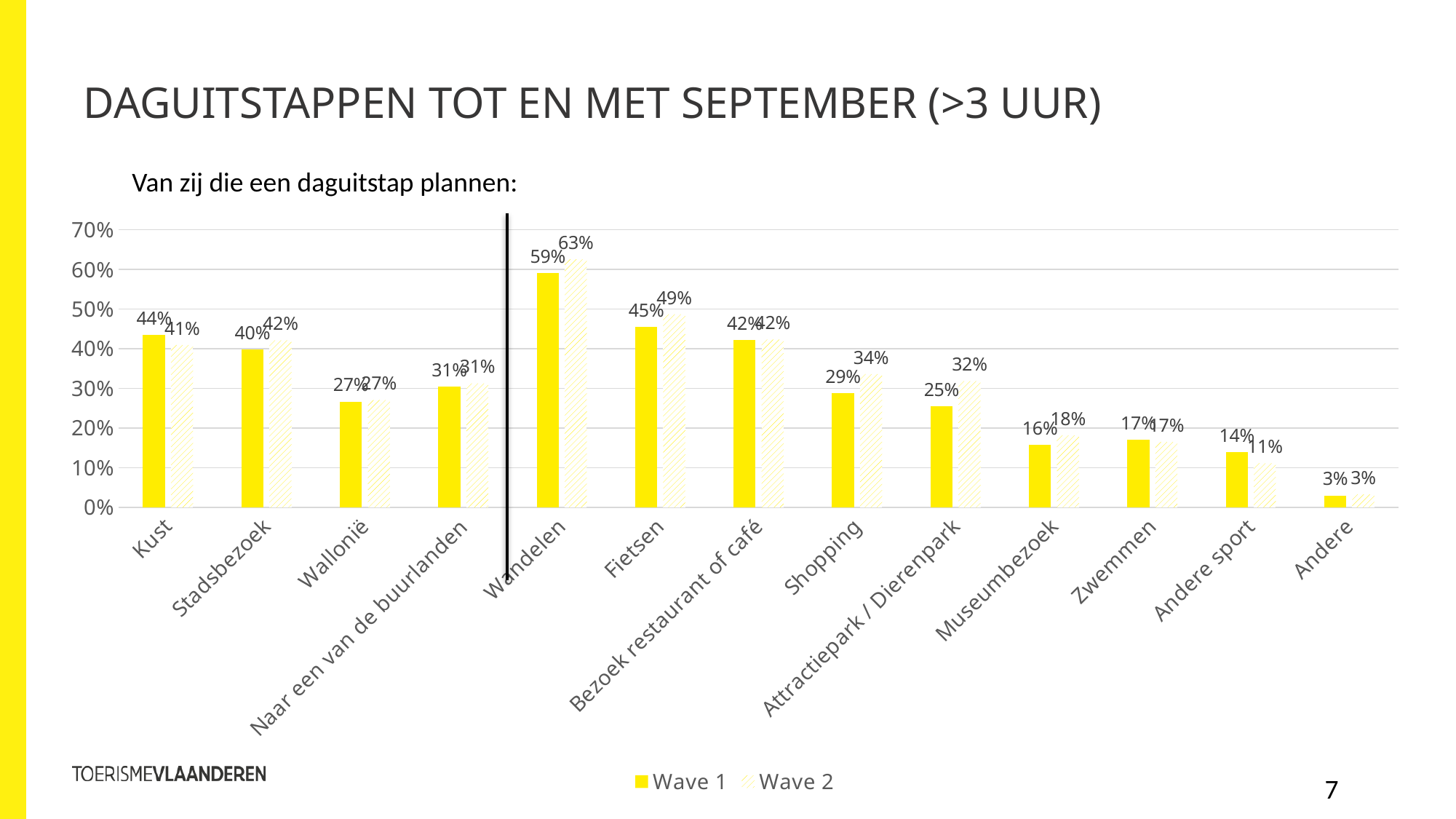
What are the names of the two series in the legend? Wave 1 and Wave 2 What is the Wave 2 value for Attractiepark / Dierenpark? 32% What kind of chart is shown on the slide? Bar chart How many series does the legend list? 2 What is the difference between the Wave 2 and Wave 1 values for Attractiepark / Dierenpark? 7% Which category has the lowest Wave 1 value? Andere Which category has the highest Wave 2 value? Wandelen Which is larger for Kust: the Wave 1 value or the Wave 2 value? Wave 1 How many categories are shown on the x axis? 13 What is the Wave 1 value for Andere sport? 14% What is the Wave 1 value for Wandelen? 59% What is the Wave 2 value for Fietsen? 49%